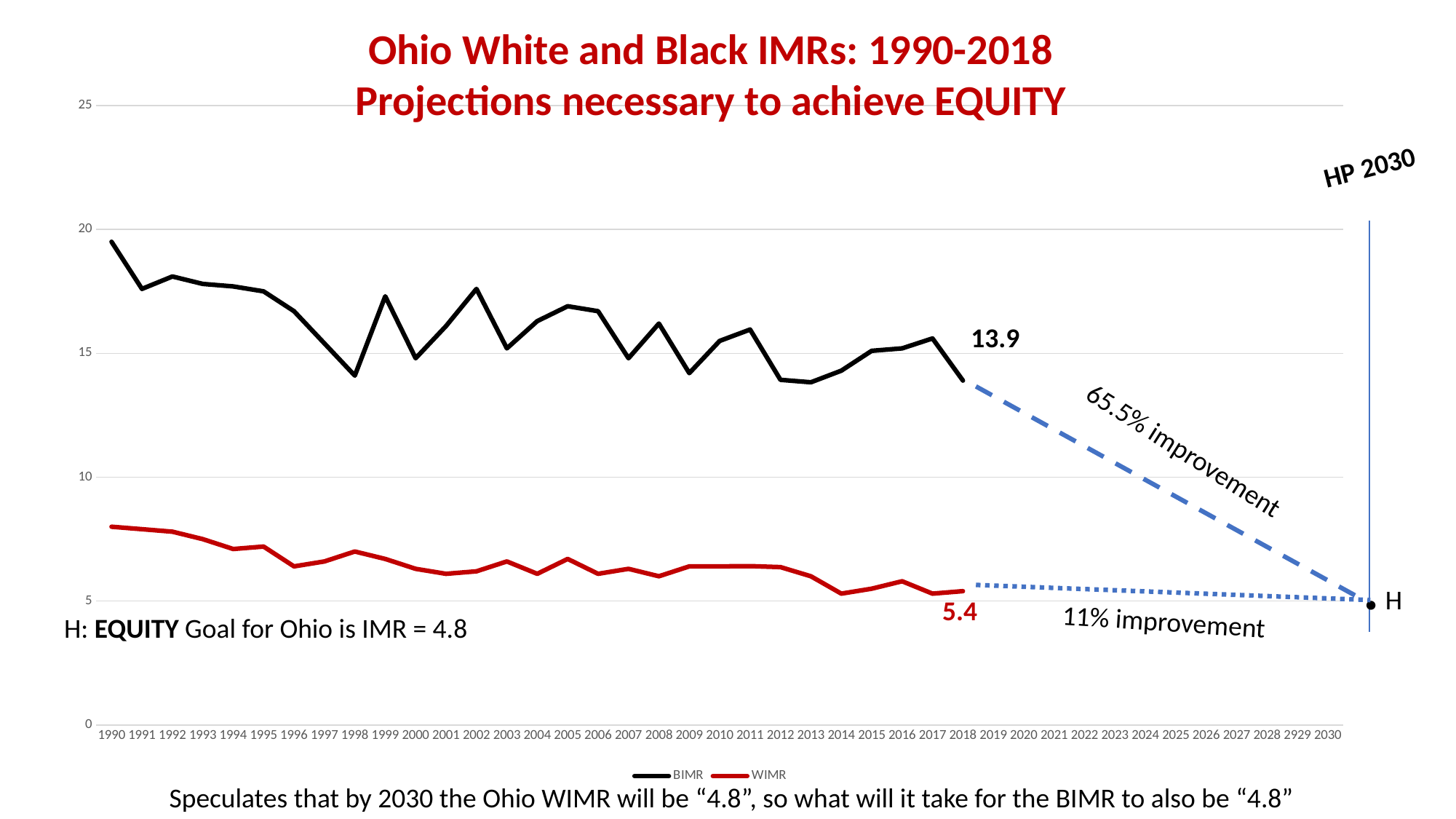
In 2018, which series has the larger value, BIMR or WIMR? BIMR Is the WIMR value for 1990 greater or less than 10? less What kind of chart is shown on the slide? Line chart Does the BIMR line generally rise or fall from 1990 to 2018? Fall What is the labeled BIMR value for 2018? 13.9 What is the EQUITY goal IMR for Ohio stated on the slide? 4.8 What is the difference between the labeled 2018 BIMR value and the labeled 2018 WIMR value? 8.5 In which year is the BIMR line at its highest? 1990 What is the labeled WIMR value for 2018? 5.4 What percentage improvement is annotated on the dashed BIMR projection line to 2030? 65.5% improvement How many series does the legend list? 2 Is the BIMR value for 1990 greater or less than 15? greater